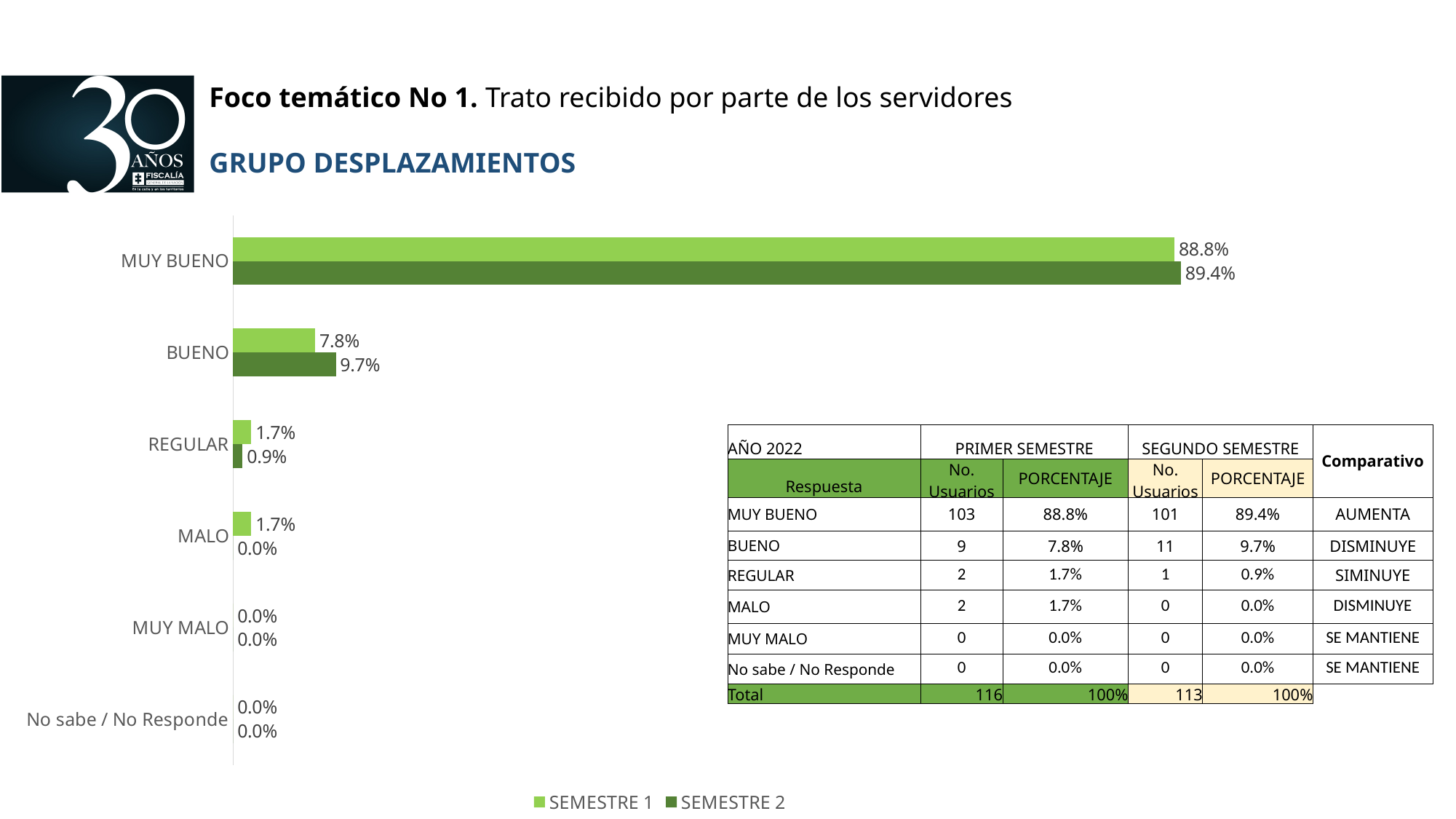
What is the difference between the SEMESTRE 2 and SEMESTRE 1 values for BUENO? 1.9% What is the value for MUY BUENO in the SEMESTRE 1 series? 88.8% What is the value for MUY BUENO in the SEMESTRE 2 series? 89.4% What are the two series named in the legend? SEMESTRE 1 and SEMESTRE 2 What is the value for MALO in the SEMESTRE 2 series? 0.0% How many categories are shown on the chart? 6 What is the value for BUENO in the SEMESTRE 2 series? 9.7% Which is larger for MUY BUENO, the SEMESTRE 1 value or the SEMESTRE 2 value? SEMESTRE 2 Which category has the highest value in the SEMESTRE 1 series? MUY BUENO How many series does the legend list? 2 What is the value for REGULAR in the SEMESTRE 1 series? 1.7% What kind of chart is shown on the slide? Bar chart